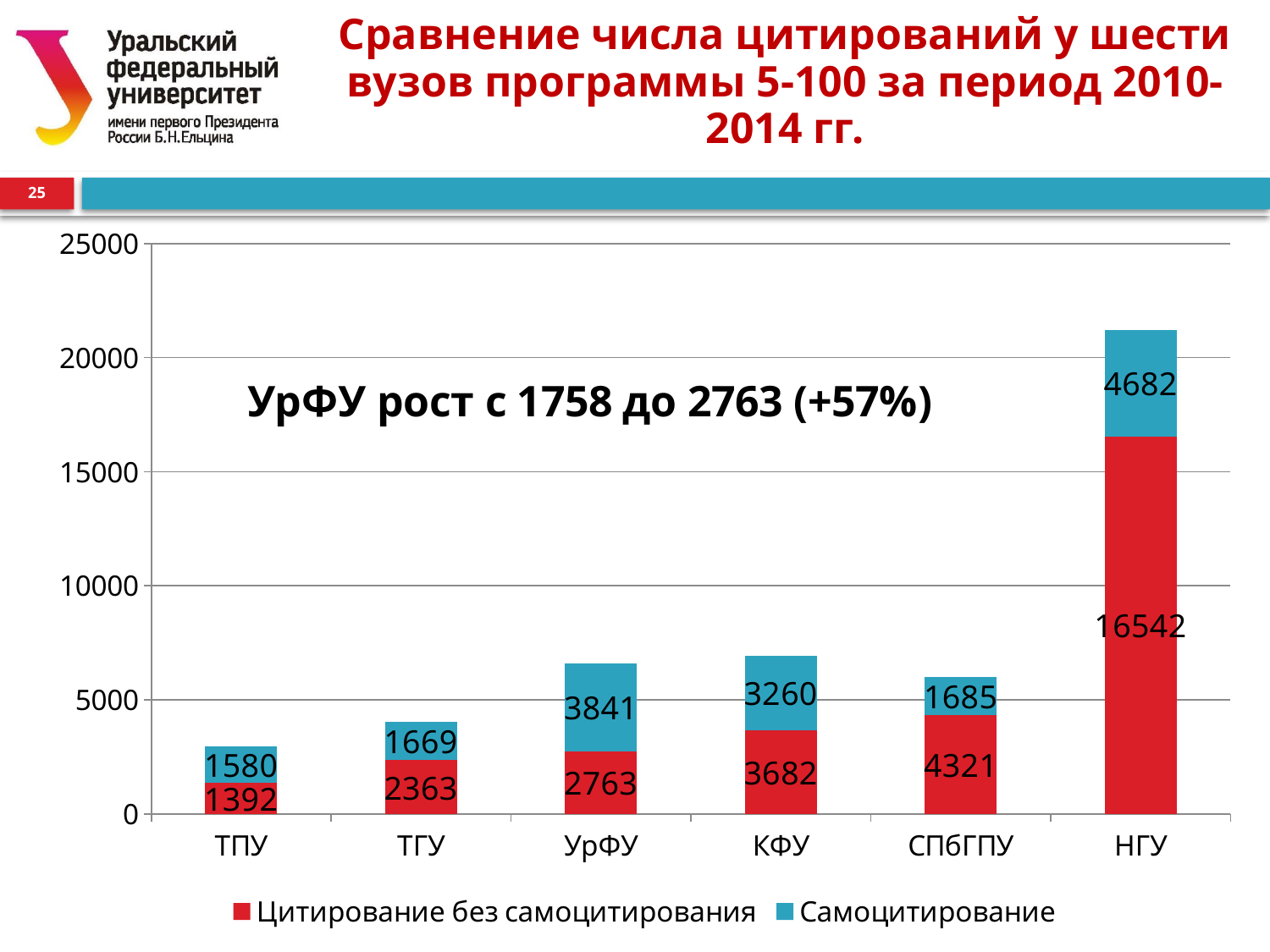
What is the difference between the 'Самоцитирование' values for НГУ and КФУ? 1422 How many series does the legend list? 2 What kind of chart is shown on the slide? Stacked bar chart What is the total of the stacked bar for КФУ? 6942 Which university has the lowest value of 'Цитирование без самоцитирования'? ТПУ Which is larger: the 'Самоцитирование' value for ТГУ or for СПбГПУ? СПбГПУ What is the value of 'Цитирование без самоцитирования' for НГУ? 16542 How many universities are shown on the x axis? 6 What is the value of 'Самоцитирование' for УрФУ? 3841 Which university has the highest value of 'Цитирование без самоцитирования'? НГУ Is the total height of the stacked bar for НГУ greater or less than 20000? greater What is the value of 'Цитирование без самоцитирования' for СПбГПУ? 4321